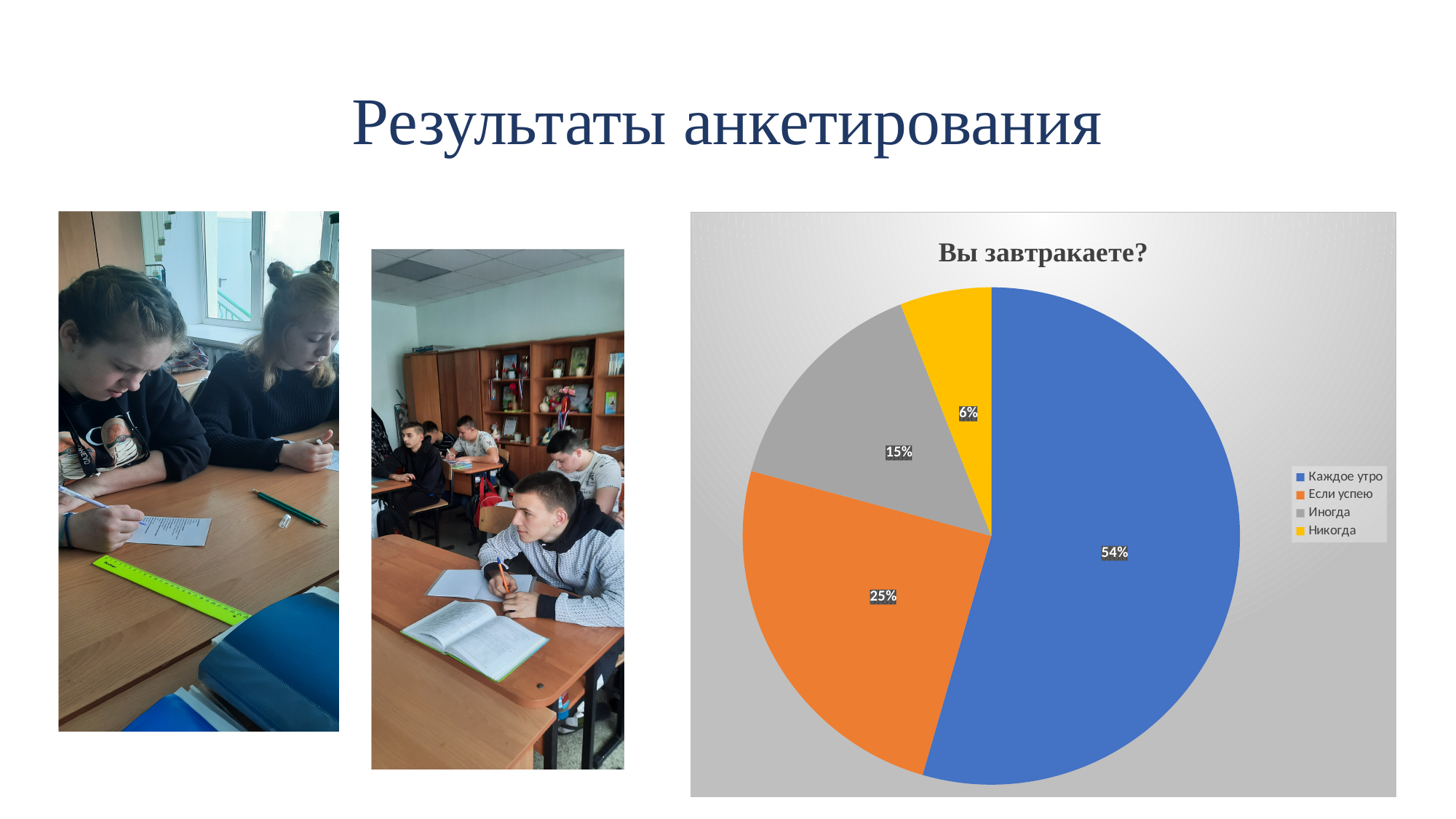
Which category has the smallest share of the pie? Никогда What percentage of the pie is labelled for "Каждое утро"? 54% What is the title of the chart? Вы завтракаете? Which category has the largest share of the pie? Каждое утро What type of chart is shown on the slide? Pie chart What colour is the slice for "Никогда"? Yellow How many categories does the legend list? 4 What percentage of the pie is labelled for "Иногда"? 15% Which is larger, the share for "Иногда" or the share for "Никогда"? Иногда What is the difference in percentage points between "Каждое утро" and "Если успею"? 29 What percentage of the pie is labelled for "Если успею"? 25% What percentage of the pie is labelled for "Никогда"? 6%